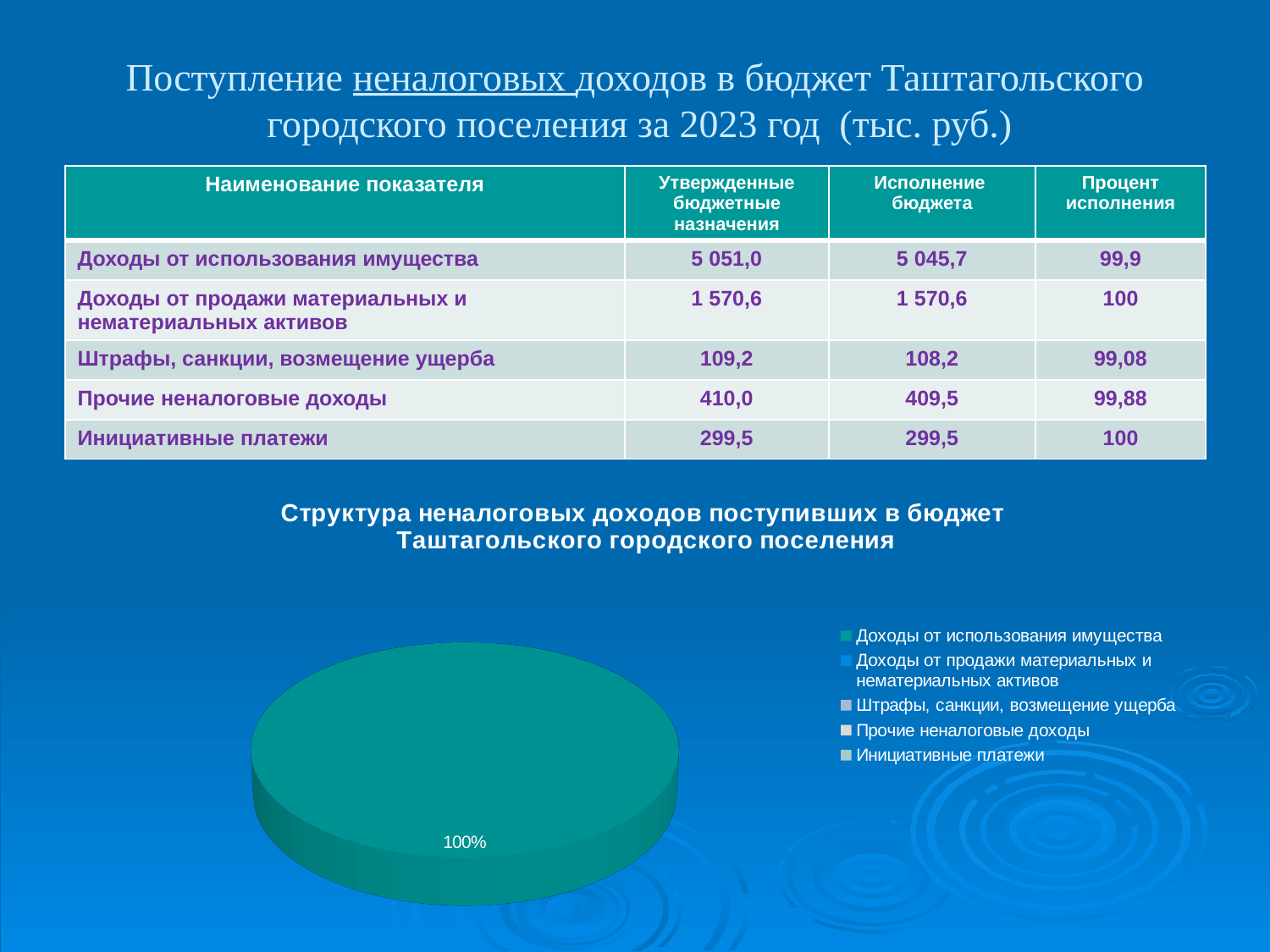
How many entries does the legend of the pie chart list? 5 What percentage is printed as the data label on the pie chart? 100% What is the title of the pie chart? Структура неналоговых доходов поступивших в бюджет Таштагольского городского поселения Which legend entry is listed first in the pie chart's legend? Доходы от использования имущества What kind of chart is shown on the slide? pie chart How many visible slices does the pie chart show? 1